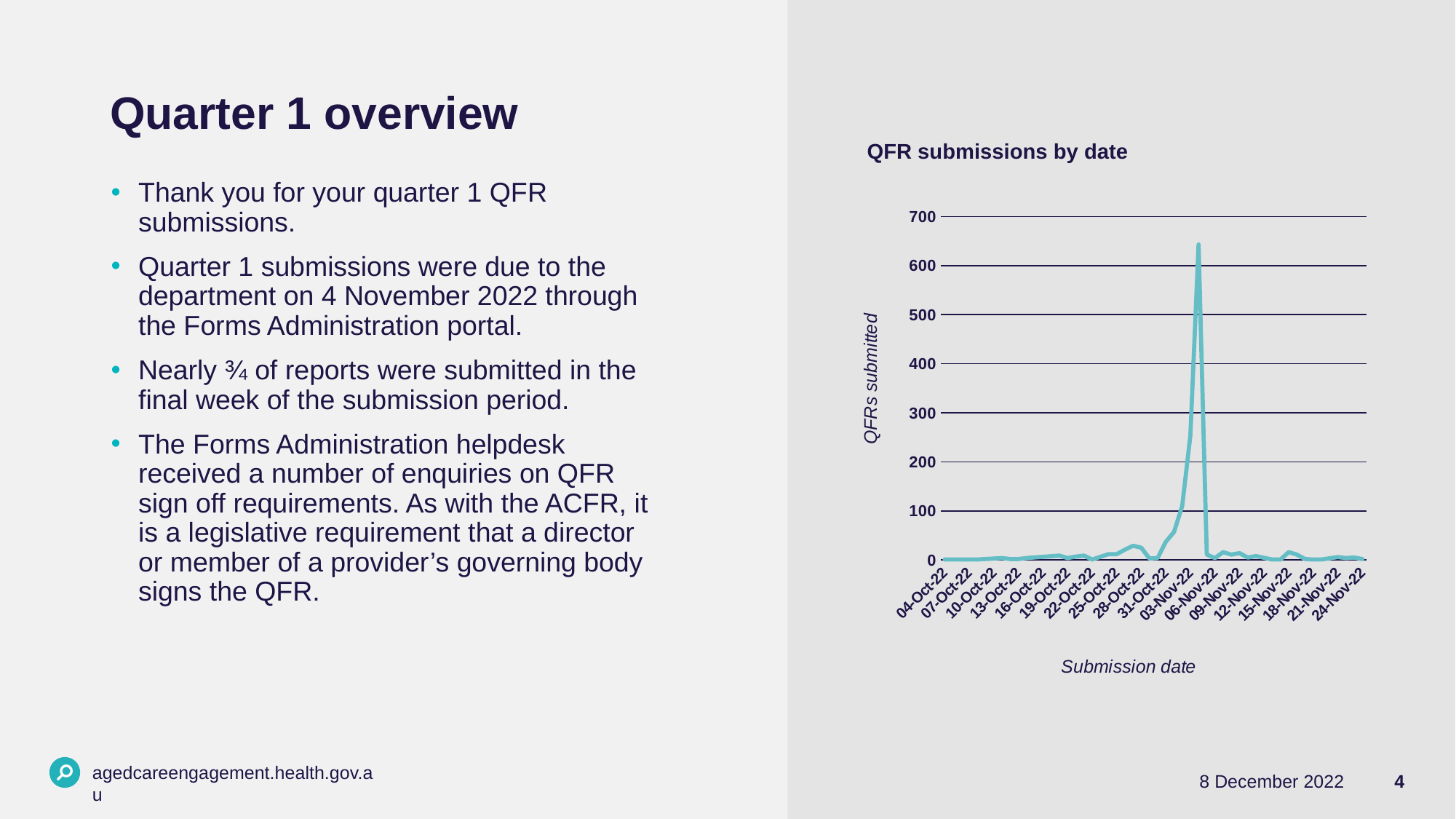
What is the label of the vertical axis of the chart? QFRs submitted What kind of chart is shown on the slide? line chart How many lines are plotted on the chart? 1 Is the value for 24-Nov-22 greater or less than 100? less Which is larger, the value for 04-Oct-22 or the peak value in early November? the peak value in early November What is the title of the chart? QFR submissions by date Is the value for 31-Oct-22 greater or less than 200? less How many date labels are shown along the x axis? 18 Do the values rise or fall between the early November peak and 09-Nov-22? fall Is the highest value on the line greater or less than 600? greater What is the highest value shown on the vertical axis? 700